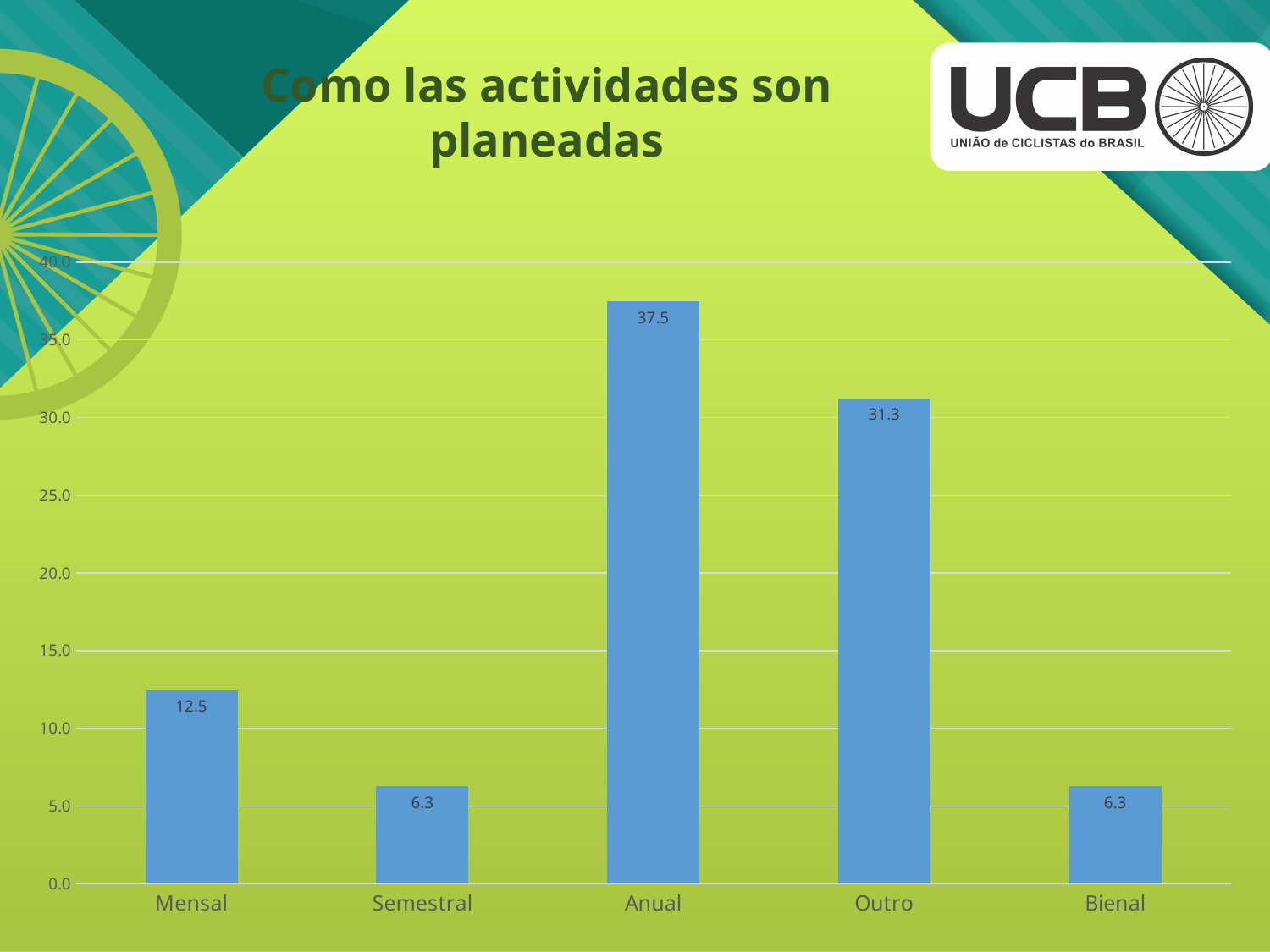
What is the difference between the values for Mensal and Semestral? 6.2 What is the value for Outro? 31.3 Which is larger, the value for Mensal or the value for Bienal? Mensal What kind of chart is shown on the slide? Bar chart How many categories are shown on the x axis? 5 Which two categories share the same value of 6.3? Semestral and Bienal What is the title of the slide? Como las actividades son planeadas What is the value for Anual? 37.5 What is the difference between the values for Anual and Outro? 6.2 Which category has the highest value? Anual What is the value for Mensal? 12.5 Is the value for Outro greater or less than 30.0? greater